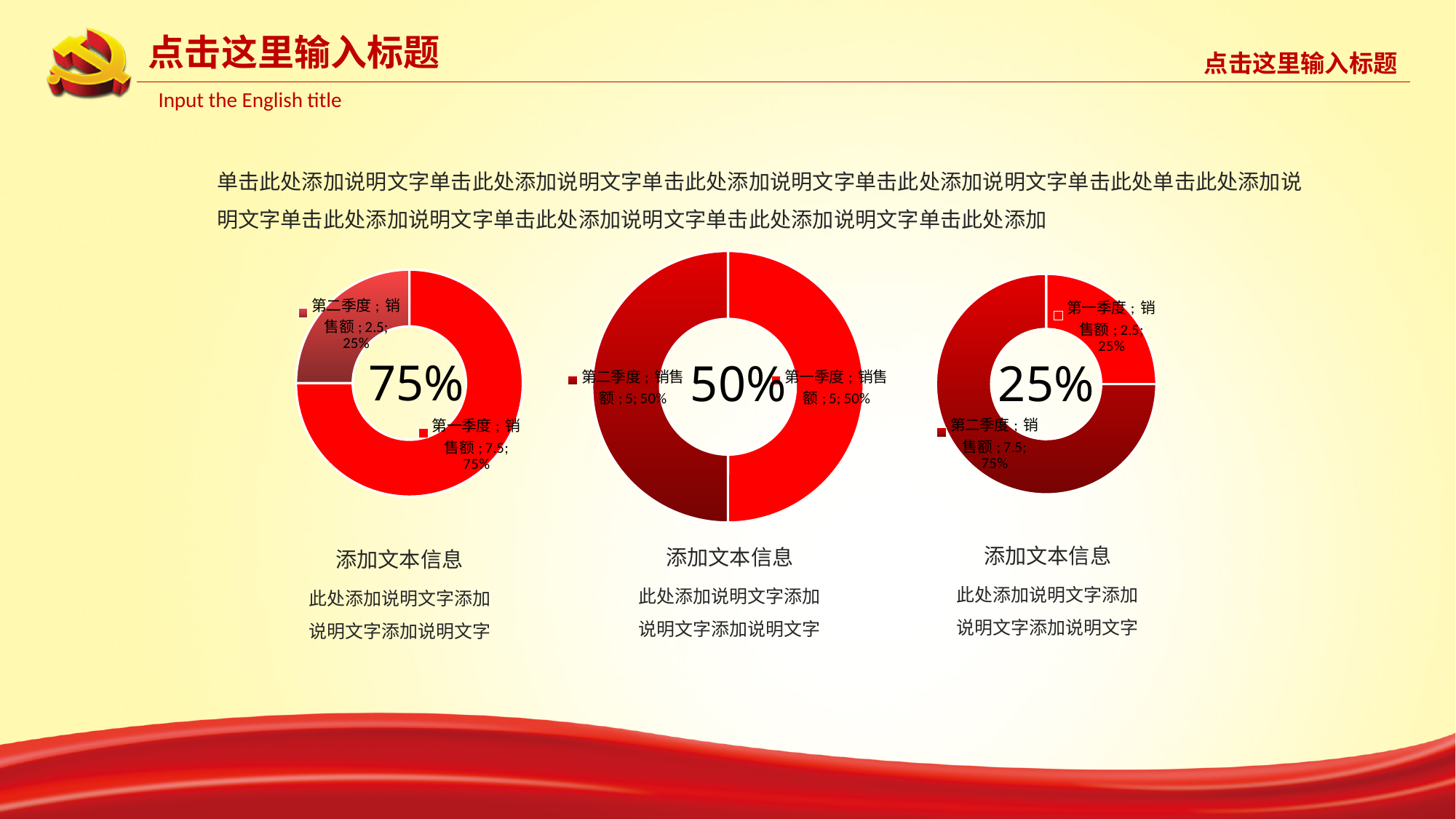
How many slices does the left doughnut chart (labelled 75% in the centre) have? 2 In the middle doughnut chart (labelled 50% in the centre), what percentage share does 第一季度 have? 50% In the right doughnut chart (labelled 25% in the centre), is the value for 第一季度 or 第二季度 larger? 第二季度 In the right doughnut chart (labelled 25% in the centre), what is the 销售额 value for 第二季度? 7.5 What kind of chart is the middle chart (labelled 50% in the centre)? Doughnut chart In the middle doughnut chart (labelled 50% in the centre), what is the 销售额 value for 第二季度? 5 In the left doughnut chart (labelled 75% in the centre), what percentage share does 第二季度 have? 25% How many doughnut charts are shown on the slide? 3 In the left doughnut chart (labelled 75% in the centre), which quarter has the larger slice? 第一季度 In the right doughnut chart (labelled 25% in the centre), which quarter has the smaller slice? 第一季度 In the left doughnut chart (labelled 75% in the centre), what is the difference between the 第一季度 and 第二季度 values? 5 In the left doughnut chart (labelled 75% in the centre), what is the 销售额 value for 第一季度? 7.5